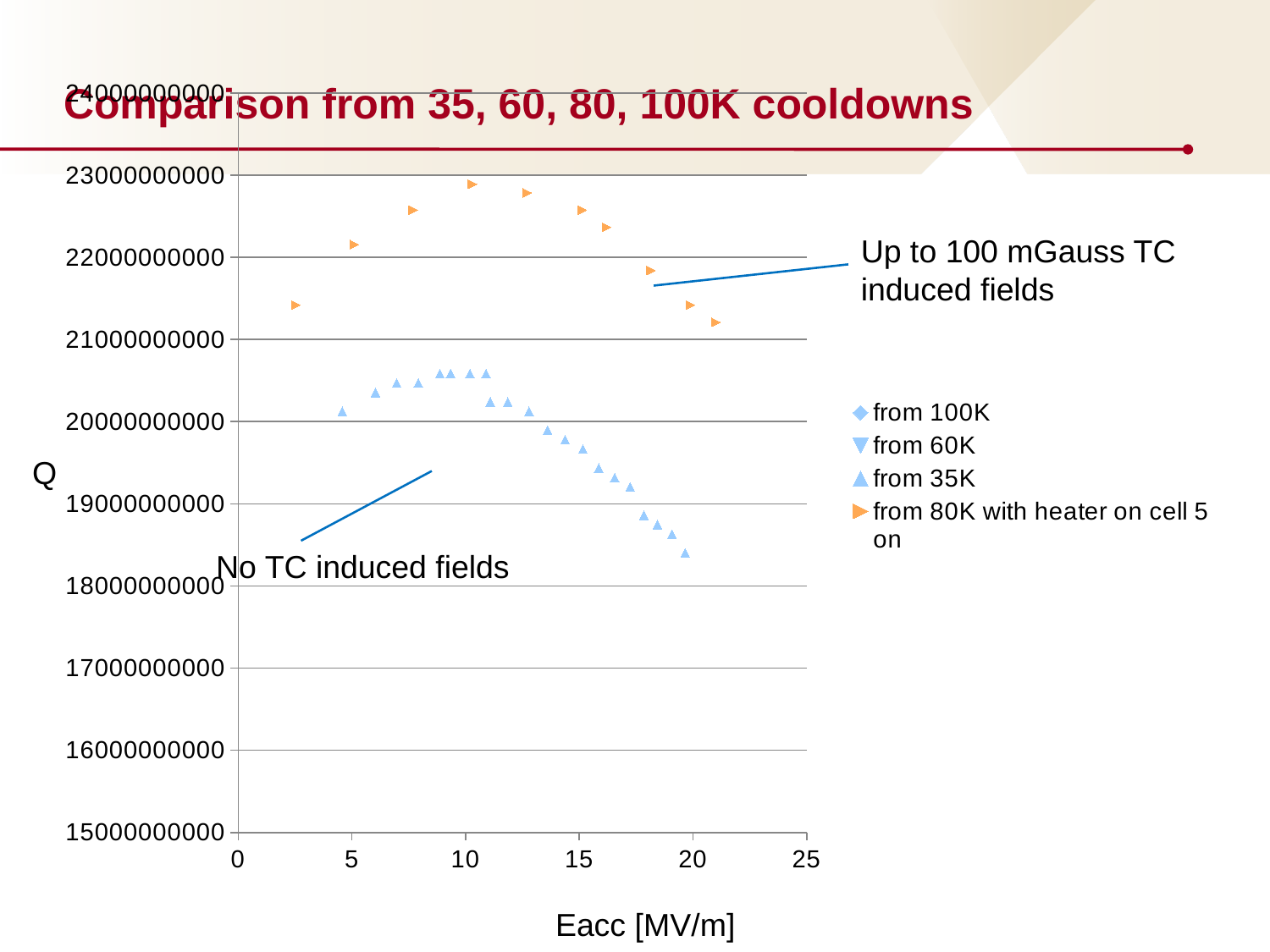
How many series does the legend list? 4 Is the Q value of the 'from 35K' series at Eacc of about 10 MV/m greater or less than 20000000000? greater Is the Q value of the 'from 35K' series at Eacc of about 20 MV/m greater or less than 19000000000? less Is the Q value of the 'from 80K with heater on cell 5 on' series at Eacc of about 10 MV/m greater or less than 22000000000? greater What is the title of the chart? Comparison from 35, 60, 80, 100K cooldowns At Eacc of about 10 MV/m, which series has the higher Q: 'from 35K' or 'from 80K with heater on cell 5 on'? from 80K with heater on cell 5 on What kind of chart is shown on the slide? Scatter chart Which plotted series reaches the highest Q value on the chart? from 80K with heater on cell 5 on Does the Q value of the 'from 35K' series rise or fall as Eacc increases from about 11 MV/m to 20 MV/m? fall What is the label of the x axis? Eacc [MV/m] Does the Q value of the 'from 80K with heater on cell 5 on' series rise or fall as Eacc increases from about 2.5 MV/m to 10 MV/m? rise